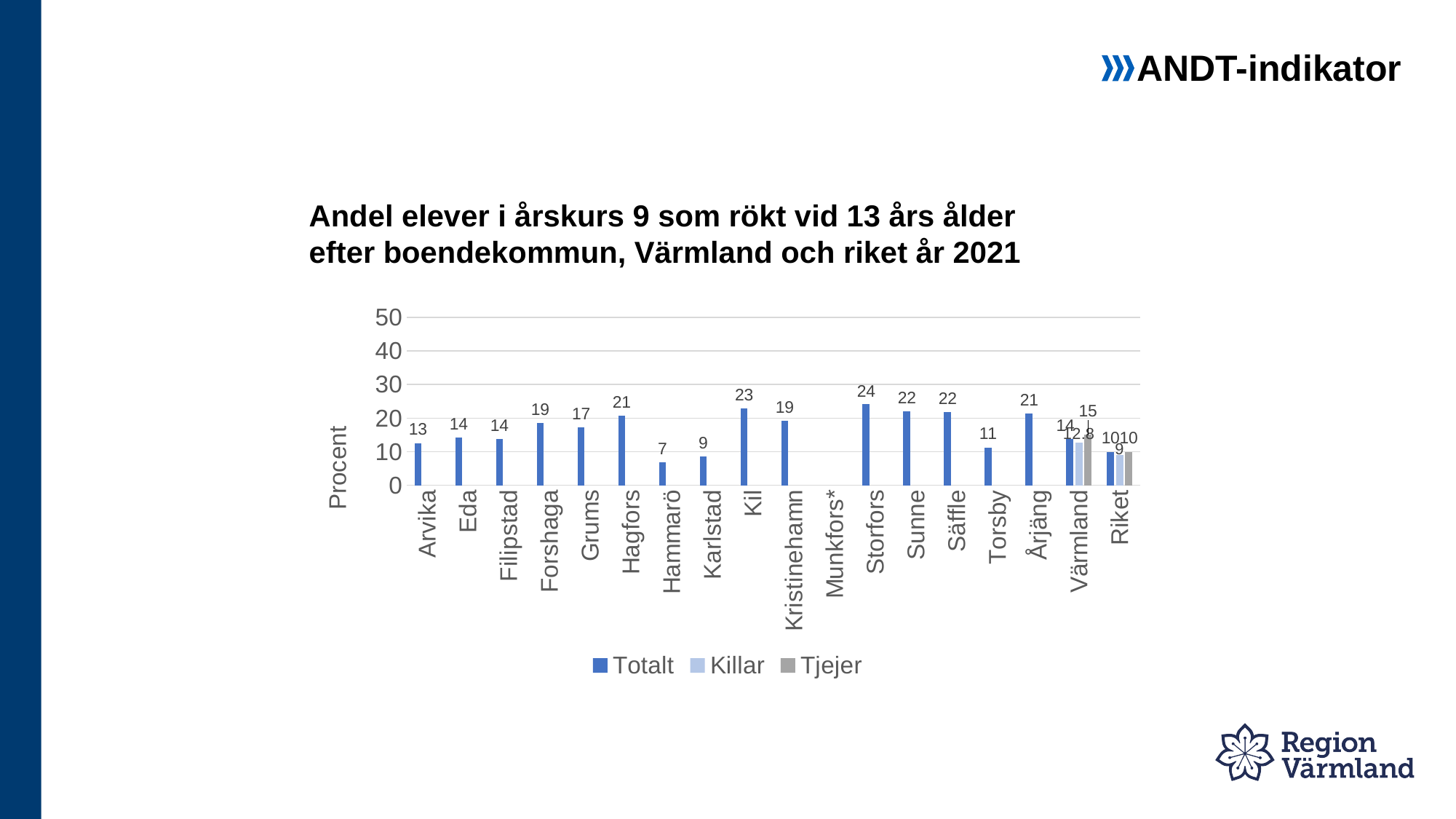
What kind of chart is shown on the slide? Bar chart What is the label on the y axis? Procent What is the Totalt value for Kil? 23 Which municipality has the highest Totalt value? Storfors What is the Tjejer value for Värmland? 15 How many categories are shown on the x axis? 18 What is the Totalt value for Hammarö? 7 How many series does the legend list? 3 What is the Tjejer value for Riket? 10 Which municipality with a plotted bar has the lowest Totalt value? Hammarö Which has a higher Totalt value, Forshaga or Grums? Forshaga What is the difference between the Totalt values for Storfors and Hammarö? 17